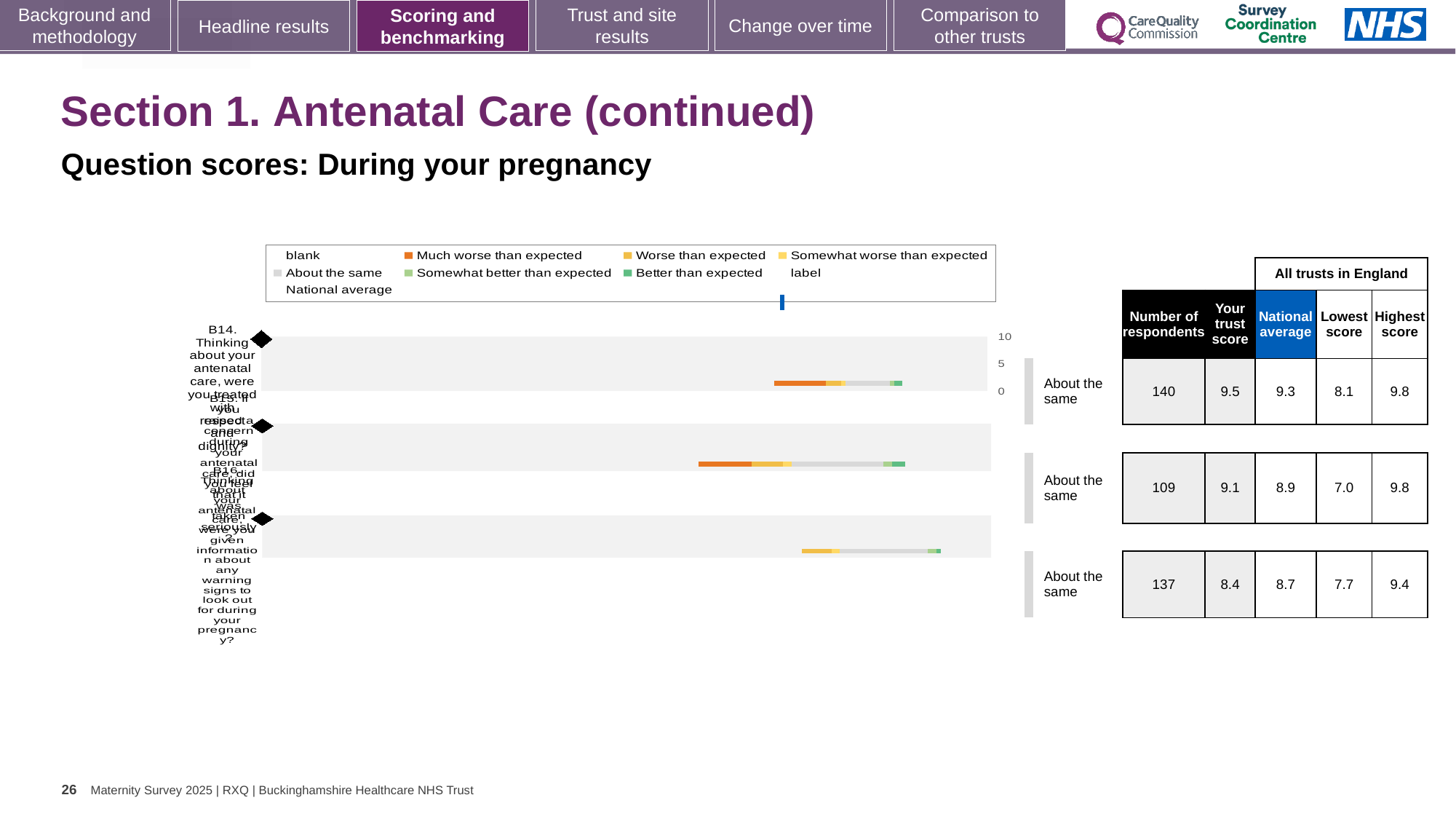
In the table beside the chart, what is the lowest score for B16 (information about warning signs)? 7.7 For B14, which is larger: the trust score or the national average? the trust score (9.5) In the table beside the chart, what is the national average for B14 (treated with respect and dignity)? 9.3 In the table beside the chart, what is the trust score for B14 (treated with respect and dignity)? 9.5 What kind of chart is shown on the slide? bar chart For B16 (information about warning signs), what is the difference between the national average and the trust score? 0.3 Which question has the highest number of respondents in the table? B14 (140) In the table beside the chart, what is the highest score for the second question (B15)? 9.8 What does the orange legend entry represent? Much worse than expected How many questions (bars) are plotted in the chart? 3 What benchmark category is shown next to each of the three bars? About the same In the table beside the chart, what is the number of respondents for B14 (treated with respect and dignity)? 140